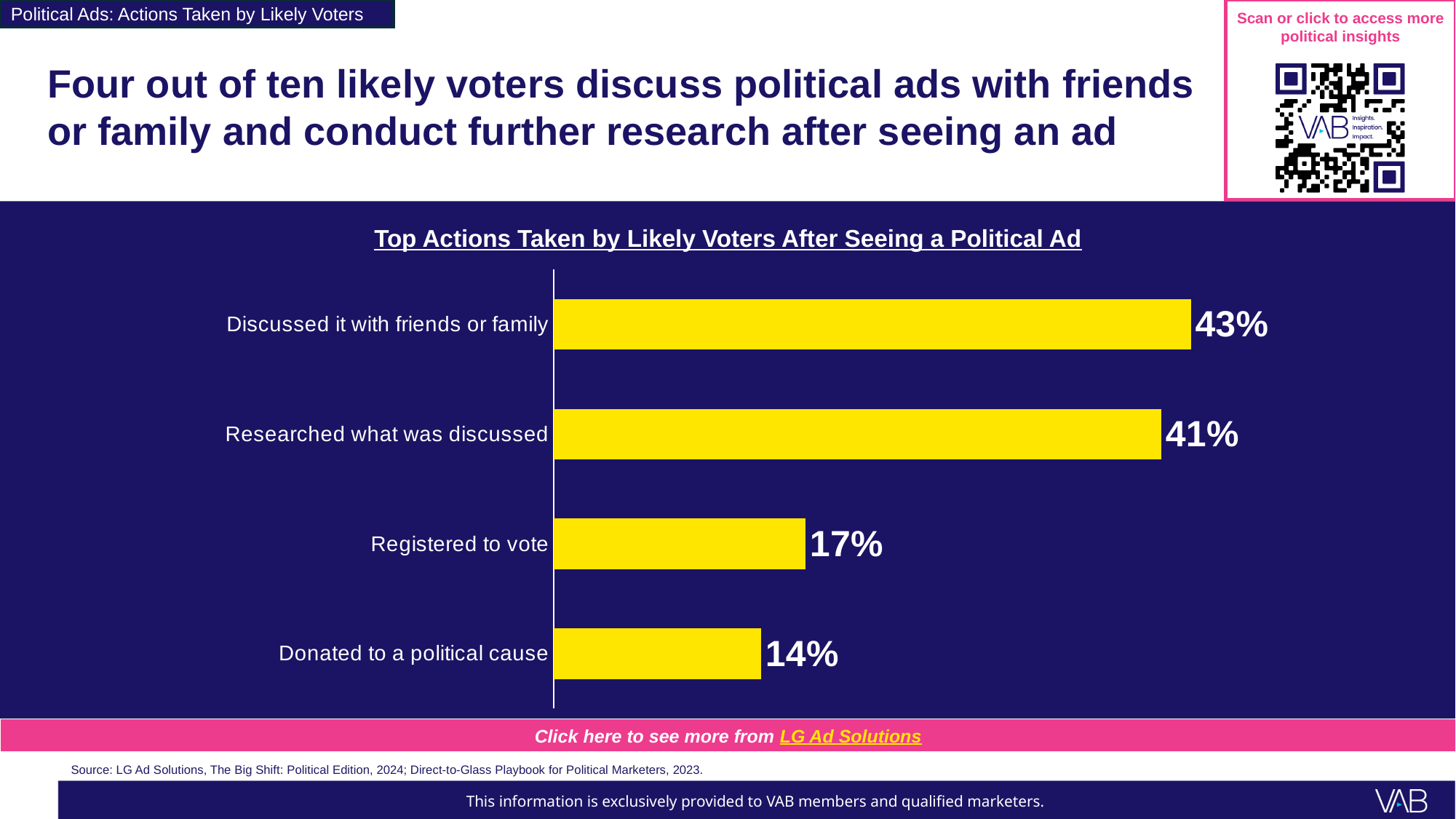
Which action has the highest percentage in the chart? Discussed it with friends or family Which action has the lowest percentage in the chart? Donated to a political cause Which is larger: the percentage for 'Researched what was discussed' or for 'Registered to vote'? Researched what was discussed What percentage of likely voters registered to vote after seeing a political ad? 17% What is the title of the chart? Top Actions Taken by Likely Voters After Seeing a Political Ad How many actions are shown in the chart? 4 What percentage of likely voters researched what was discussed after seeing a political ad? 41% What percentage of likely voters discussed the political ad with friends or family? 43% What is the difference in percentage points between 'Discussed it with friends or family' and 'Donated to a political cause'? 29 percentage points What percentage of likely voters donated to a political cause after seeing a political ad? 14% What type of chart is used to show the top actions taken by likely voters? Bar chart What is the difference in percentage points between 'Registered to vote' and 'Donated to a political cause'? 3 percentage points